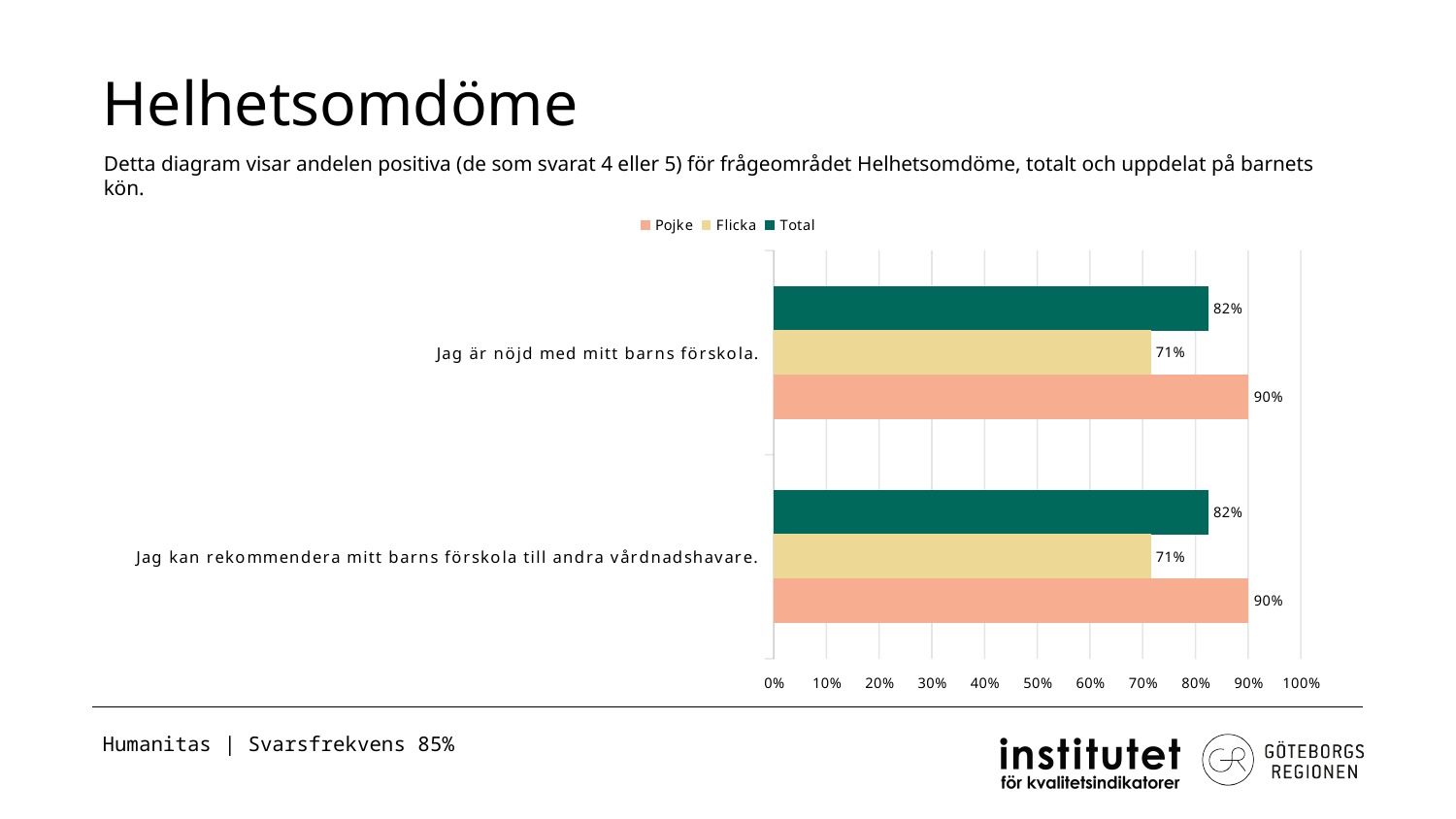
What kind of chart is shown on the slide? Bar chart What is the Pojke value for "Jag är nöjd med mitt barns förskola."? 90% How many series does the legend list? 3 Is the Flicka value for "Jag är nöjd med mitt barns förskola." greater or less than 80%? less What is the Pojke value for "Jag kan rekommendera mitt barns förskola till andra vårdnadshavare."? 90% What is the Flicka value for "Jag är nöjd med mitt barns förskola."? 71% What is the Total value for "Jag kan rekommendera mitt barns förskola till andra vårdnadshavare."? 82% Which is larger for "Jag kan rekommendera mitt barns förskola till andra vårdnadshavare.": the Total value or the Flicka value? Total Which series has the lowest value for "Jag kan rekommendera mitt barns förskola till andra vårdnadshavare."? Flicka What is the difference between the Pojke and Flicka values for "Jag är nöjd med mitt barns förskola."? 19 percentage points How many question categories are shown on the chart? 2 Which series has the highest value for "Jag är nöjd med mitt barns förskola."? Pojke